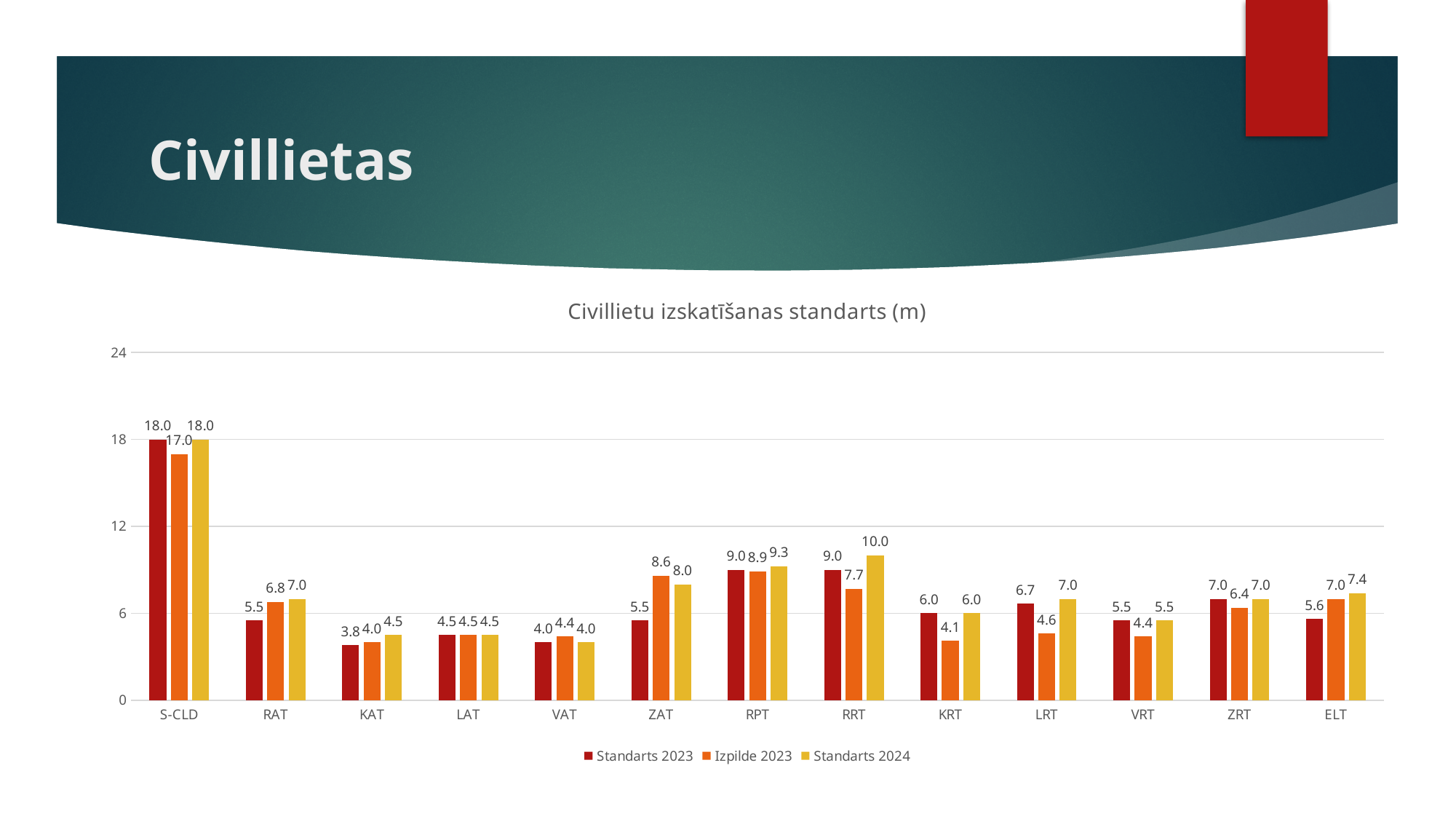
Is the Standarts 2024 value for RPT greater or less than 6? greater What is the difference between the Standarts 2024 and Izpilde 2023 values for KRT? 1.9 What is the title of the chart? Civillietu izskatīšanas standarts (m) What is the Izpilde 2023 value for S-CLD? 17.0 How many categories are shown on the x axis? 13 What kind of chart is shown on the slide? Bar chart For ZAT, which is larger: the Izpilde 2023 value or the Standarts 2023 value? Izpilde 2023 How many series does the legend list? 3 Which category has the lowest Standarts 2023 value? KAT What is the Standarts 2023 value for LRT? 6.7 What is the Standarts 2024 value for RRT? 10.0 Which category has the highest Standarts 2023 value? S-CLD